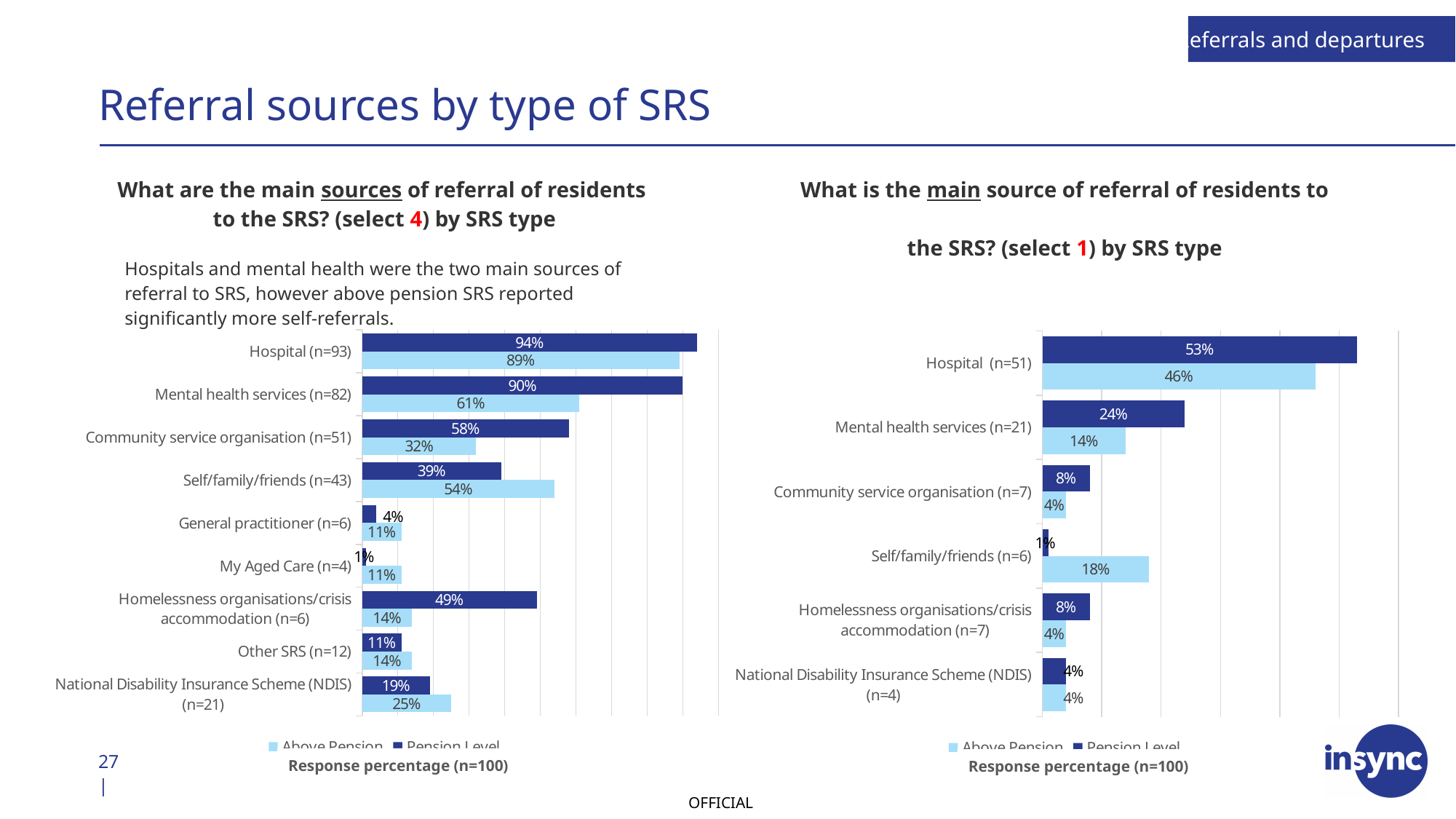
In the right chart (select 1), what is the difference between the Pension Level and Above Pension values for Hospital (n=51)? 7% In the left chart (select 4), what is the Above Pension value for Mental health services (n=82)? 61% In the left chart (select 4), what is the Pension Level value for Hospital (n=93)? 94% In the left chart (select 4), how many referral source categories are shown? 9 In the right chart (select 1), which is larger for Mental health services (n=21): the Pension Level value or the Above Pension value? Pension Level What type of chart is the left chart (select 4)? Bar chart How many series does the legend of the right chart (select 1) list? 2 In the right chart (select 1), what is the Above Pension value for Self/family/friends (n=6)? 18% In the left chart (select 4), what is the difference between the Pension Level and Above Pension values for Homelessness organisations/crisis accommodation (n=6)? 35% In the right chart (select 1), what is the Pension Level value for Hospital (n=51)? 53% In the left chart (select 4), which category has the highest Pension Level value? Hospital (n=93) In the left chart (select 4), what is the Above Pension value for Self/family/friends (n=43)? 54%